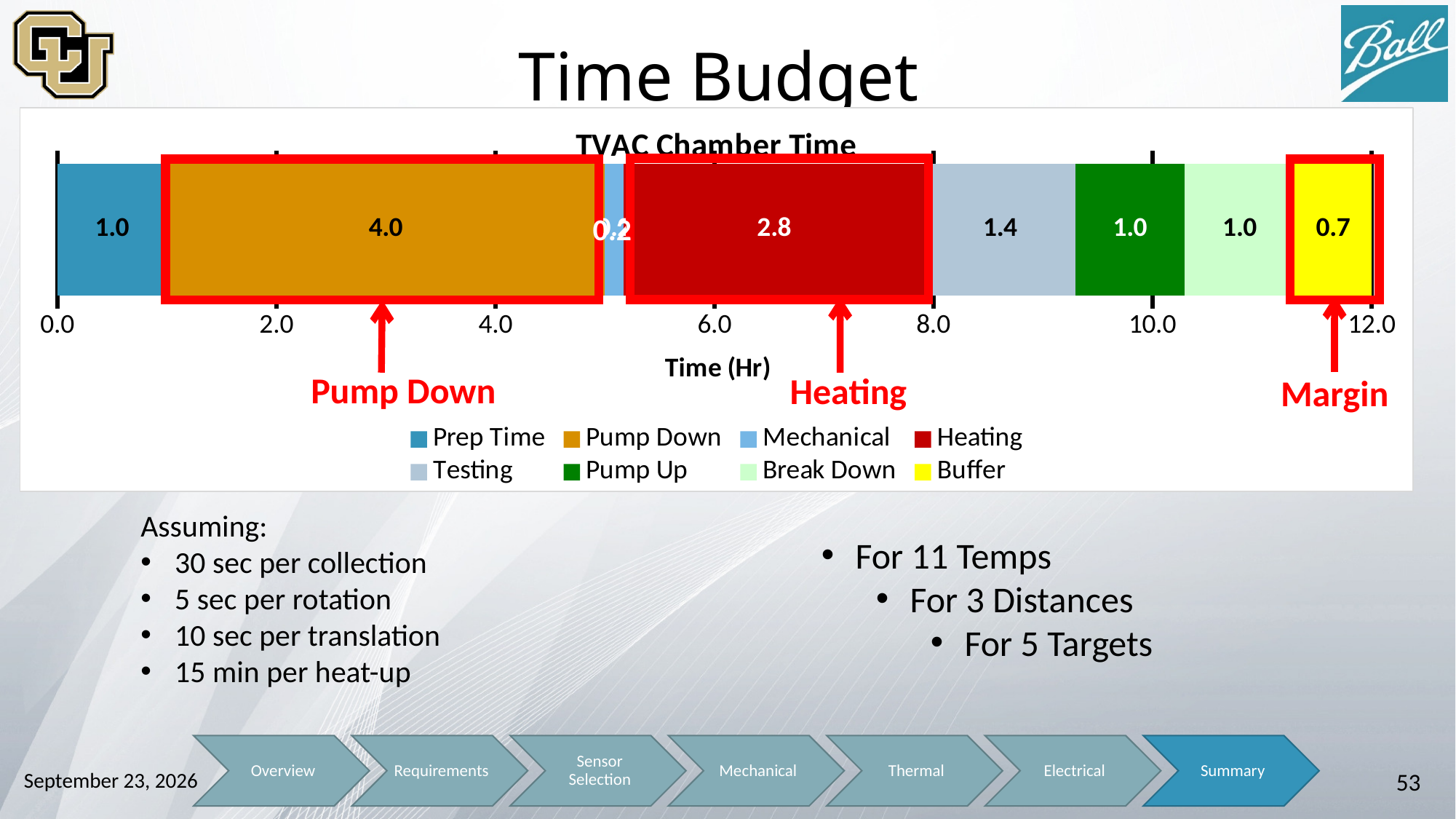
What is the value for Testing in the TVAC Chamber Time chart? 1.4 What is the x-axis label of the TVAC Chamber Time chart? Time (Hr) What kind of chart is the TVAC Chamber Time chart? Stacked bar chart Which is larger in the TVAC Chamber Time chart, Testing or Pump Up? Testing Which series has the smallest value in the TVAC Chamber Time chart? Mechanical What is the value for Pump Down in the TVAC Chamber Time chart? 4.0 What is the total of all segments in the TVAC Chamber Time stacked bar? 12.1 What is the value for Heating in the TVAC Chamber Time chart? 2.8 What is the value for Buffer in the TVAC Chamber Time chart? 0.7 How many series does the legend of the TVAC Chamber Time chart list? 8 What is the difference between the Pump Down and Heating values in the TVAC Chamber Time chart? 1.2 Which series has the largest value in the TVAC Chamber Time chart? Pump Down